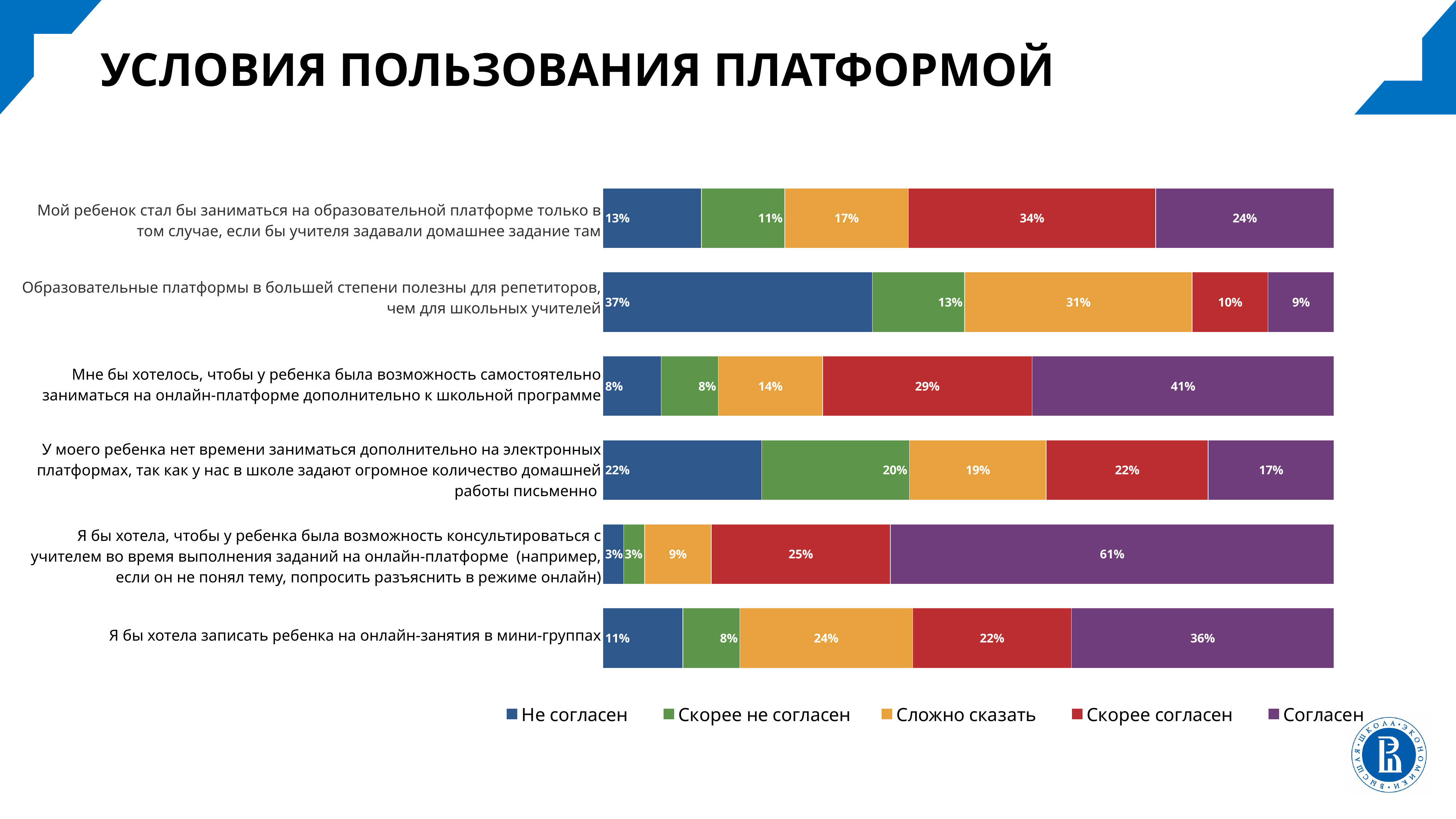
What type of chart is shown on the slide? Stacked bar chart Which statement has the highest "Согласен" value? Я бы хотела, чтобы у ребенка была возможность консультироваться с учителем во время выполнения заданий на онлайн-платформе Which statement has the lowest "Не согласен" value? Я бы хотела, чтобы у ребенка была возможность консультироваться с учителем во время выполнения заданий на онлайн-платформе What is the total of the "Не согласен" and "Скорее не согласен" segments for the statement "У моего ребенка нет времени заниматься дополнительно на электронных платформах..."? 42% How many statements (categories) are plotted in the chart? 6 How many series does the legend list? 5 For the statement "Мой ребенок стал бы заниматься на образовательной платформе только в том случае, если бы учителя задавали домашнее задание там", which is larger: "Скорее согласен" or "Согласен"? Скорее согласен What is the "Согласен" value for the statement "Я бы хотела записать ребенка на онлайн-занятия в мини-группах"? 36% What is the "Не согласен" value for the statement "Образовательные платформы в большей степени полезны для репетиторов, чем для школьных учителей"? 37% What is the difference between the "Согласен" value (41%) and the "Скорее согласен" value (29%) for the statement "Мне бы хотелось, чтобы у ребенка была возможность самостоятельно заниматься на онлайн-платформе..."? 12% What is the "Сложно сказать" value for the statement "У моего ребенка нет времени заниматься дополнительно на электронных платформах..."? 19% Which colour represents the "Сложно сказать" series in the legend? Orange